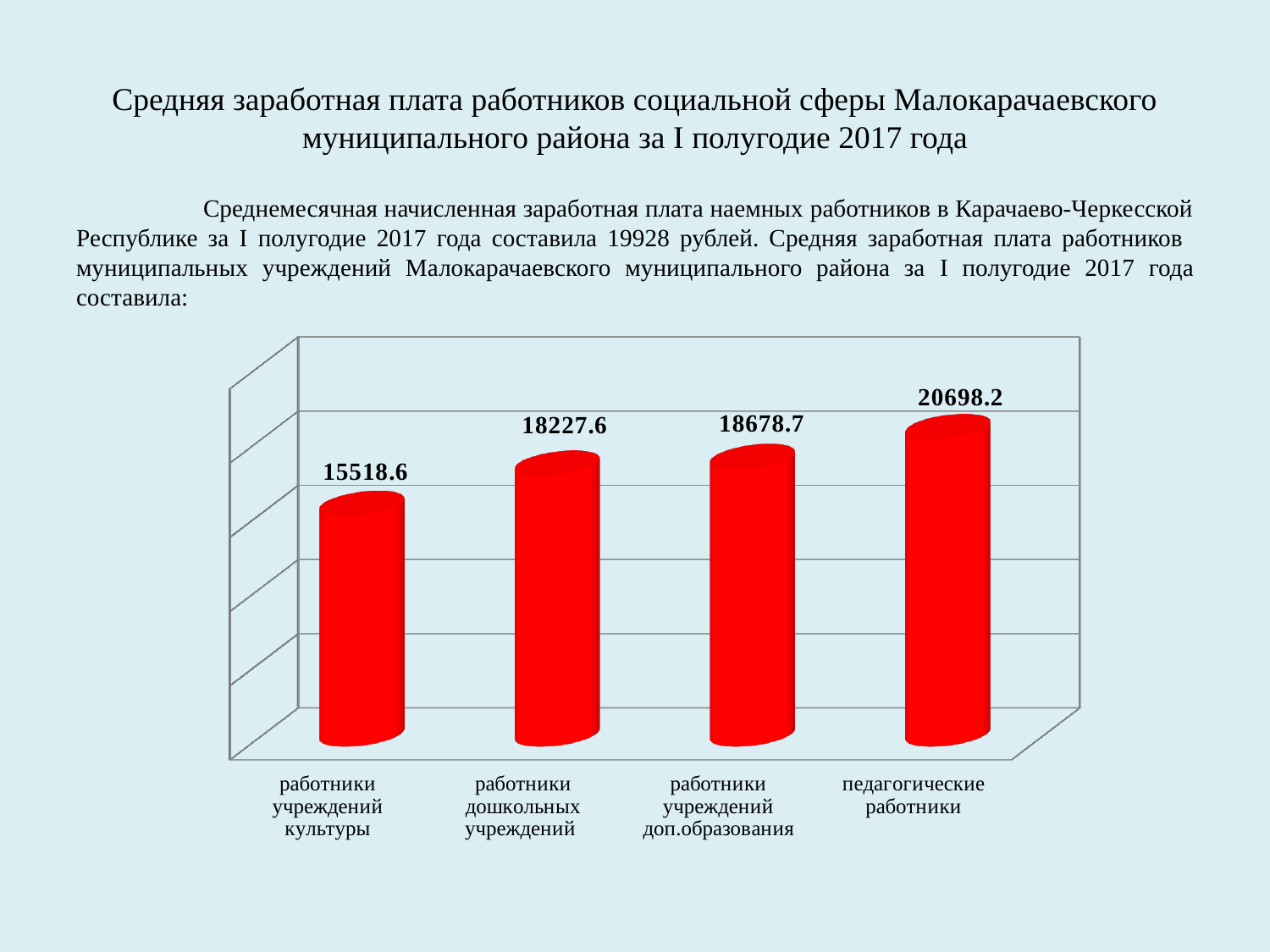
Which category has the lowest value on the chart? работники учреждений культуры Do the values rise or fall from left to right across the categories? rise What is the difference between the values for работники учреждений доп.образования and работники дошкольных учреждений? 451.1 What kind of chart is shown on the slide? bar chart How many categories are shown on the chart? 4 Which is larger: the value for работники дошкольных учреждений or for работники учреждений доп.образования? работники учреждений доп.образования What is the value shown for педагогические работники? 20698.2 What is the value shown for работники дошкольных учреждений? 18227.6 What is the value shown for работники учреждений доп.образования? 18678.7 What is the difference between the values for педагогические работники and работники учреждений культуры? 5179.6 What is the average salary shown for работники учреждений культуры? 15518.6 Which category has the highest value on the chart? педагогические работники